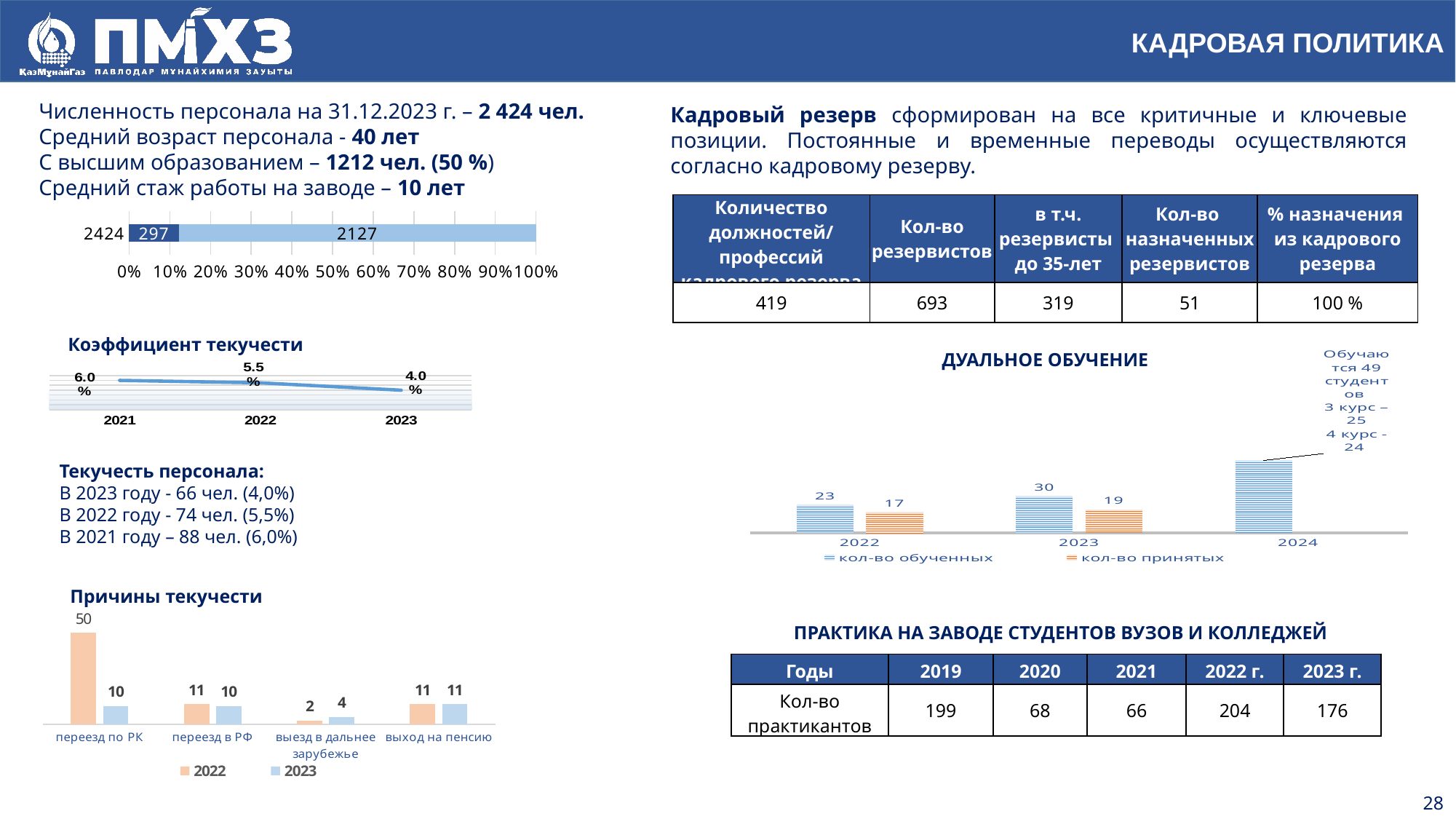
In the 'ДУАЛЬНОЕ ОБУЧЕНИЕ' chart, what kind of chart is it? bar chart In the 'ДУАЛЬНОЕ ОБУЧЕНИЕ' chart, which is larger for 2022: 'кол-во обученных' or 'кол-во принятых'? кол-во обученных In the 'Причины текучести' chart, which category has the lowest 2022 value? выезд в дальнее зарубежье In the 'Коэффициент текучести' chart, do the values rise or fall from 2021 to 2023? fall In the 'Коэффициент текучести' chart, what is the difference between the 2021 and 2023 values? 2.0% In the 'Коэффициент текучести' chart, what is the value for 2023? 4.0% In the 'Причины текучести' chart, what is the 2022 value for 'переезд по РК'? 50 In the stacked horizontal bar chart under the personnel text, what is the total of the bar labelled 2424? 2424 In the 'Причины текучести' chart, which category has the highest 2022 value? переезд по РК In the 'Причины текучести' chart, how many series does the legend list? 2 In the 'Причины текучести' chart, what is the difference between the 2022 and 2023 values for 'переезд по РК'? 40 In the 'ДУАЛЬНОЕ ОБУЧЕНИЕ' chart, what is the 'кол-во обученных' value for 2023? 30